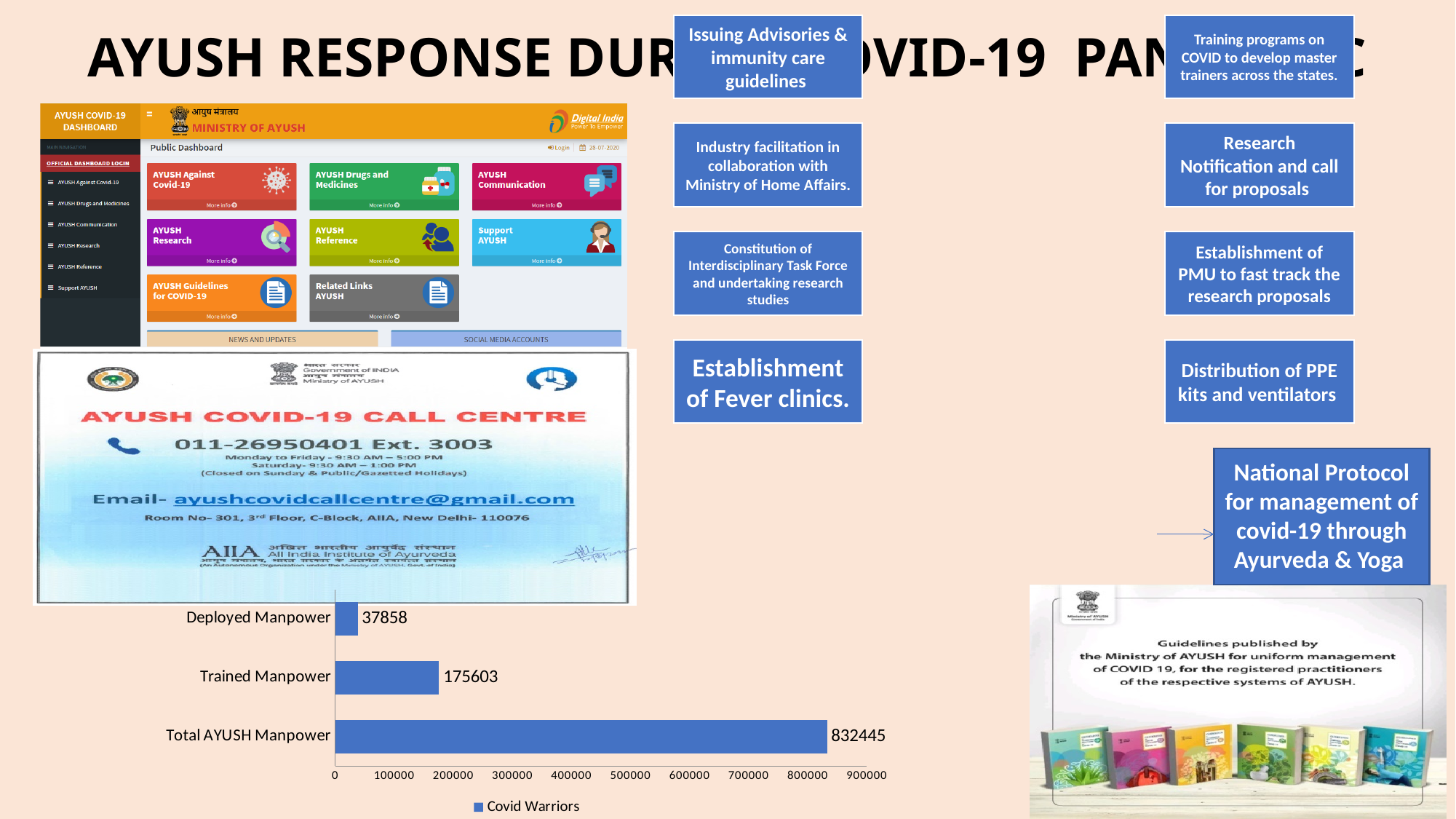
What is the value for Deployed Manpower in the bar chart? 37858 What is the value for Trained Manpower in the bar chart? 175603 How many categories are shown in the bar chart? 3 Which is larger in the bar chart, Trained Manpower or Deployed Manpower? Trained Manpower What is the difference between Total AYUSH Manpower and Trained Manpower in the bar chart? 656842 What kind of chart is shown at the bottom of the slide? bar chart Which category has the highest value in the bar chart? Total AYUSH Manpower Is the value for Trained Manpower greater or less than 200000? less What is the value for Total AYUSH Manpower in the bar chart? 832445 What is the difference between Trained Manpower and Deployed Manpower in the bar chart? 137745 What series name does the legend of the bar chart show? Covid Warriors Which category has the lowest value in the bar chart? Deployed Manpower